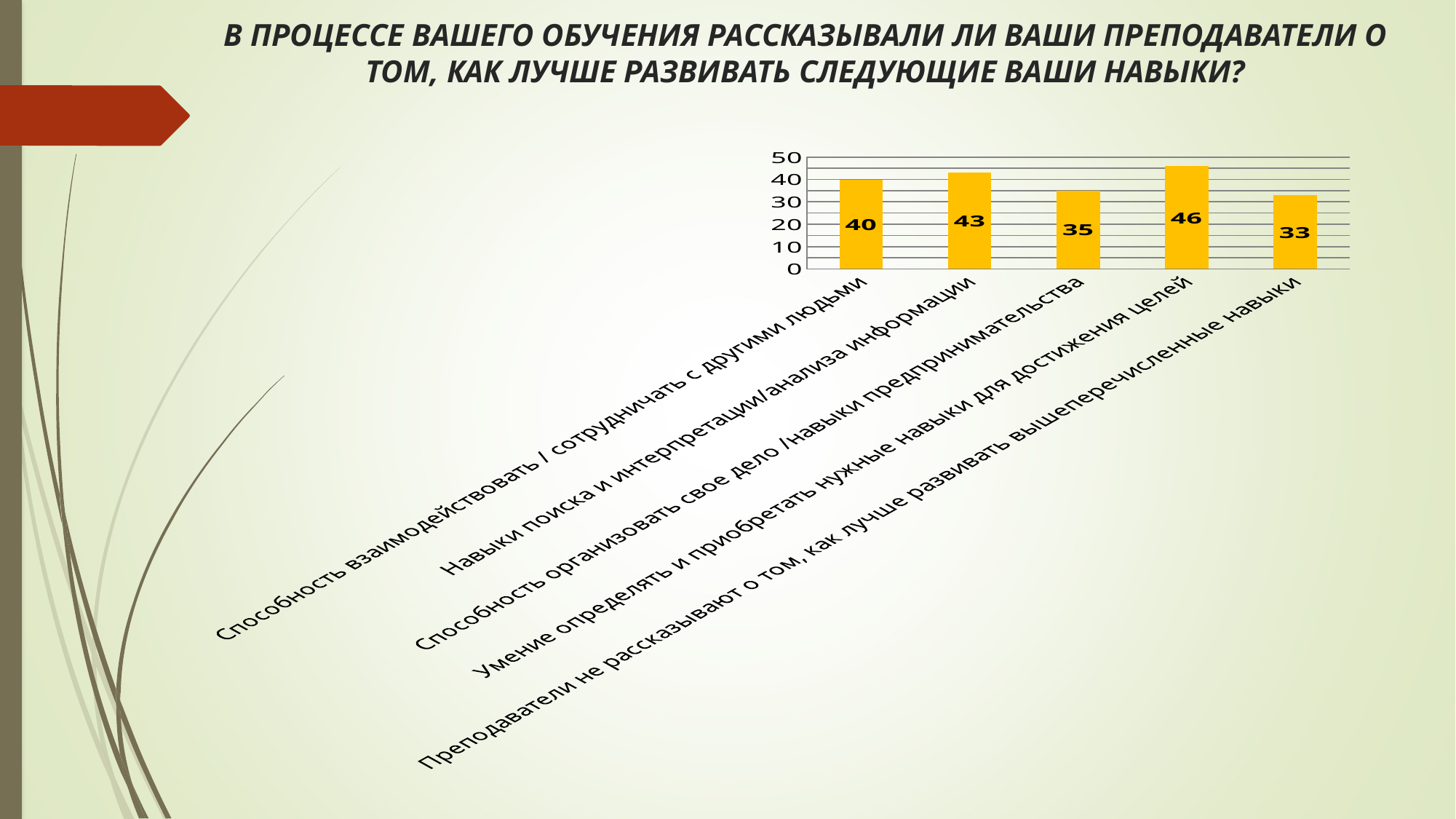
What is the value for "Навыки поиска и интерпретации/анализа информации"? 43 What colour are the bars in the chart? yellow What is the value for "Преподаватели не рассказывают о том, как лучше развивать вышеперечисленные навыки"? 33 What kind of chart is shown on the slide? bar chart Is the value for "Способность организовать свое дело /навыки предпринимательства" greater or less than 40? less Which category has the highest value? Умение определять и приобретать нужные навыки для достижения целей How many categories are shown in the chart? 5 What is the value for "Способность организовать свое дело /навыки предпринимательства"? 35 What is the difference between the values for "Умение определять и приобретать нужные навыки для достижения целей" and "Преподаватели не рассказывают о том, как лучше развивать вышеперечисленные навыки"? 13 Which is larger: the value for "Навыки поиска и интерпретации/анализа информации" or for "Способность взаимодействовать / сотрудничать с другими людьми"? Навыки поиска и интерпретации/анализа информации What is the value for "Способность взаимодействовать / сотрудничать с другими людьми"? 40 Which category has the lowest value? Преподаватели не рассказывают о том, как лучше развивать вышеперечисленные навыки